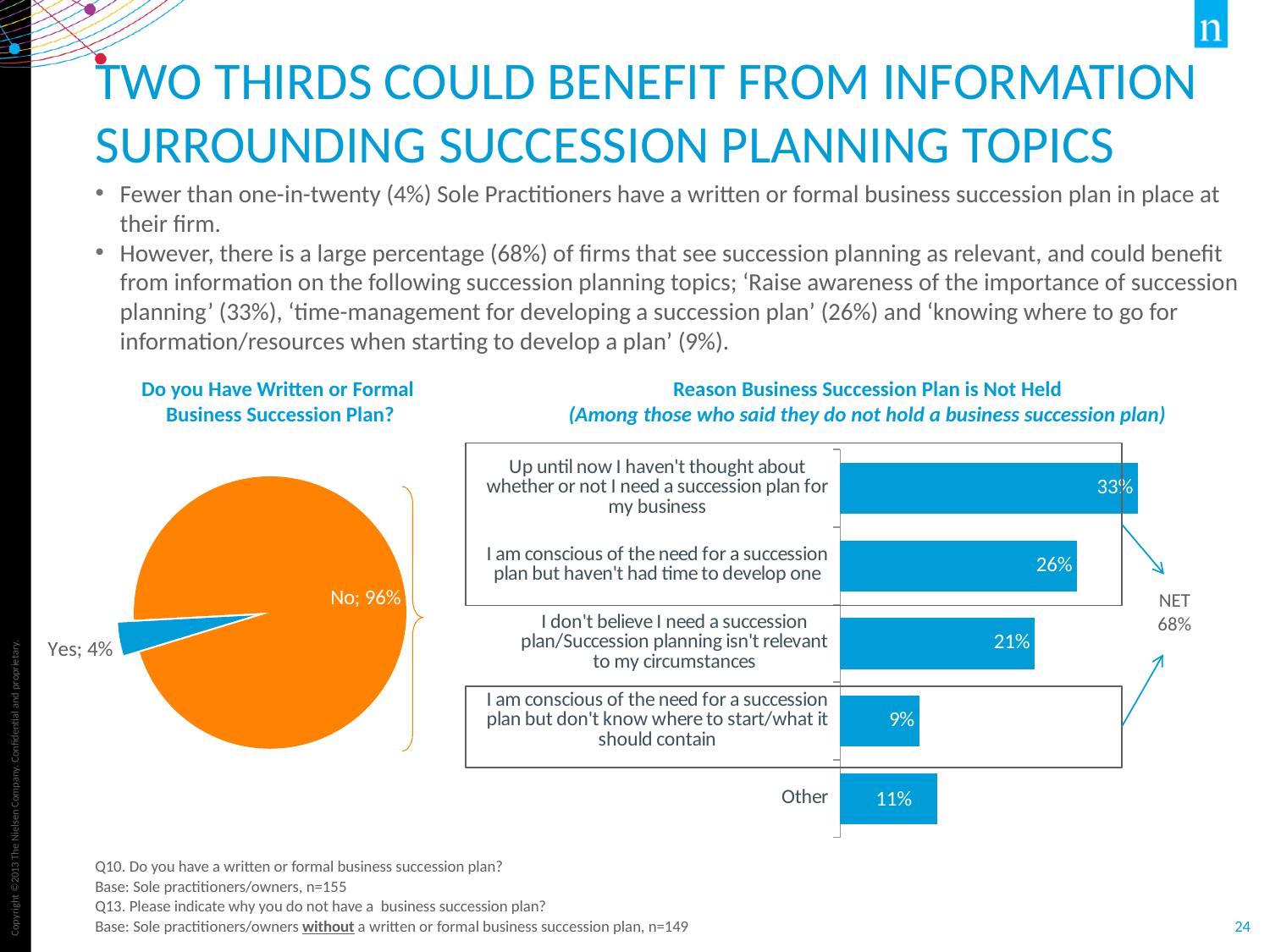
In the chart 'Reason Business Succession Plan is Not Held', what is the difference between 'I don't believe I need a succession plan/Succession planning isn't relevant to my circumstances' and 'Other'? 10% In the chart 'Reason Business Succession Plan is Not Held', what is the value for 'Up until now I haven't thought about whether or not I need a succession plan for my business'? 33% In the pie chart 'Do you Have Written or Formal Business Succession Plan?', what percentage answered Yes? 4% In the chart 'Reason Business Succession Plan is Not Held', what is the value for 'I am conscious of the need for a succession plan but haven't had time to develop one'? 26% In the chart 'Reason Business Succession Plan is Not Held', what is the value for 'Other'? 11% In the chart 'Reason Business Succession Plan is Not Held', how many reason categories are plotted? 5 In the chart 'Reason Business Succession Plan is Not Held', which reason has the lowest value? I am conscious of the need for a succession plan but don't know where to start/what it should contain In the pie chart 'Do you Have Written or Formal Business Succession Plan?', what percentage answered No? 96% In the pie chart 'Do you Have Written or Formal Business Succession Plan?', what is the difference between the No and Yes shares? 92% In the chart 'Reason Business Succession Plan is Not Held', which reason has the highest value? Up until now I haven't thought about whether or not I need a succession plan for my business In the pie chart 'Do you Have Written or Formal Business Succession Plan?', how many slices are shown? 2 What type of chart is 'Reason Business Succession Plan is Not Held'? Bar chart